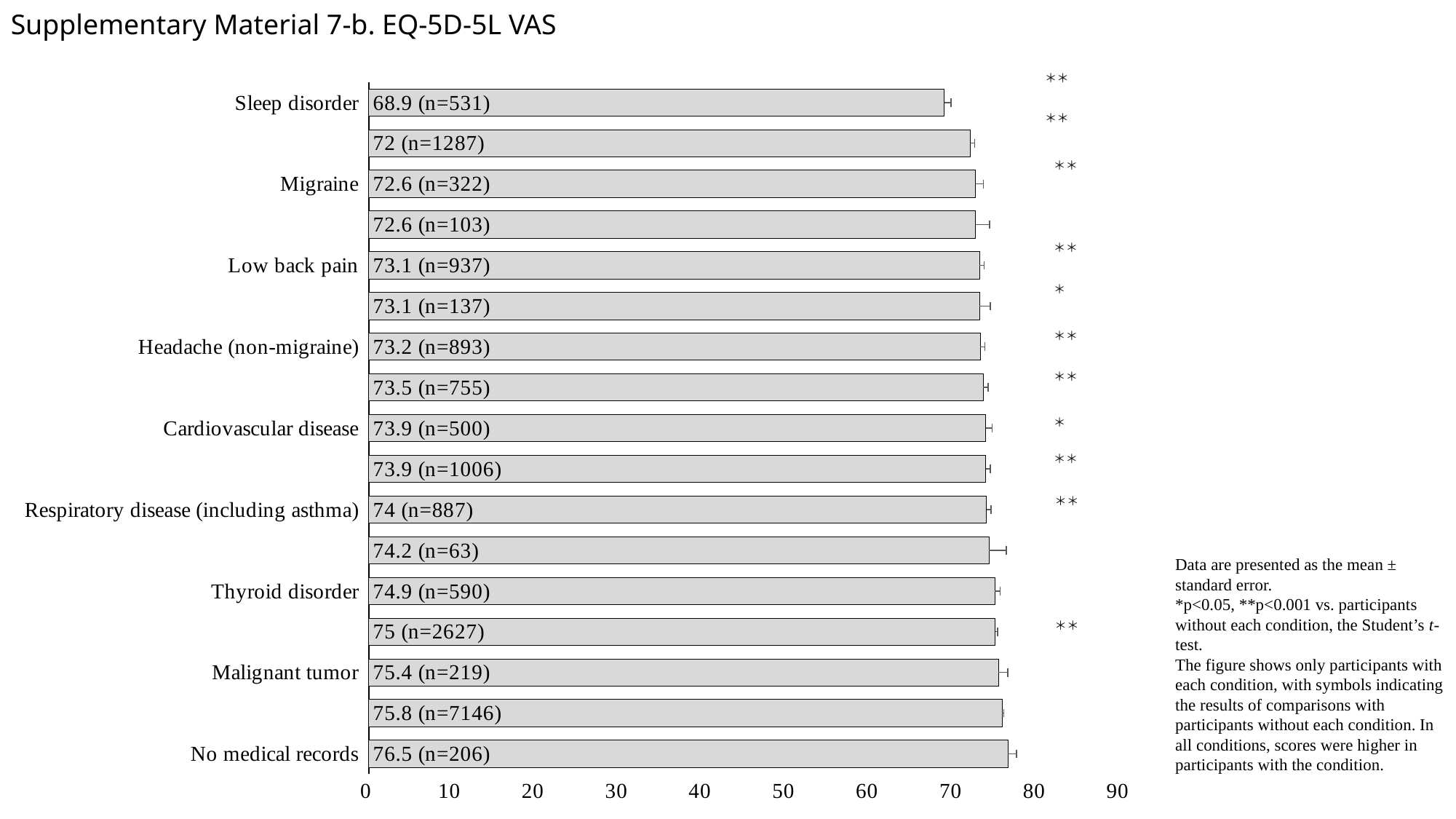
Which labelled category has the lowest value? Sleep disorder What is the difference between the values for No medical records and Sleep disorder? 7.6 What is the value shown for Thyroid disorder? 74.9 What kind of chart is shown on the slide? bar chart Do the bar values increase or decrease going from the top of the chart to the bottom? increase Is the value for Sleep disorder greater or less than 70? less What is the sample size (n) shown for Low back pain? 937 What is the mean EQ-5D-5L VAS value shown for Sleep disorder? 68.9 Which labelled category has the highest value? No medical records How many bars are plotted in the chart? 17 What is the value labelled on the bar for No medical records? 76.5 Which has a larger value, Malignant tumor or Migraine? Malignant tumor